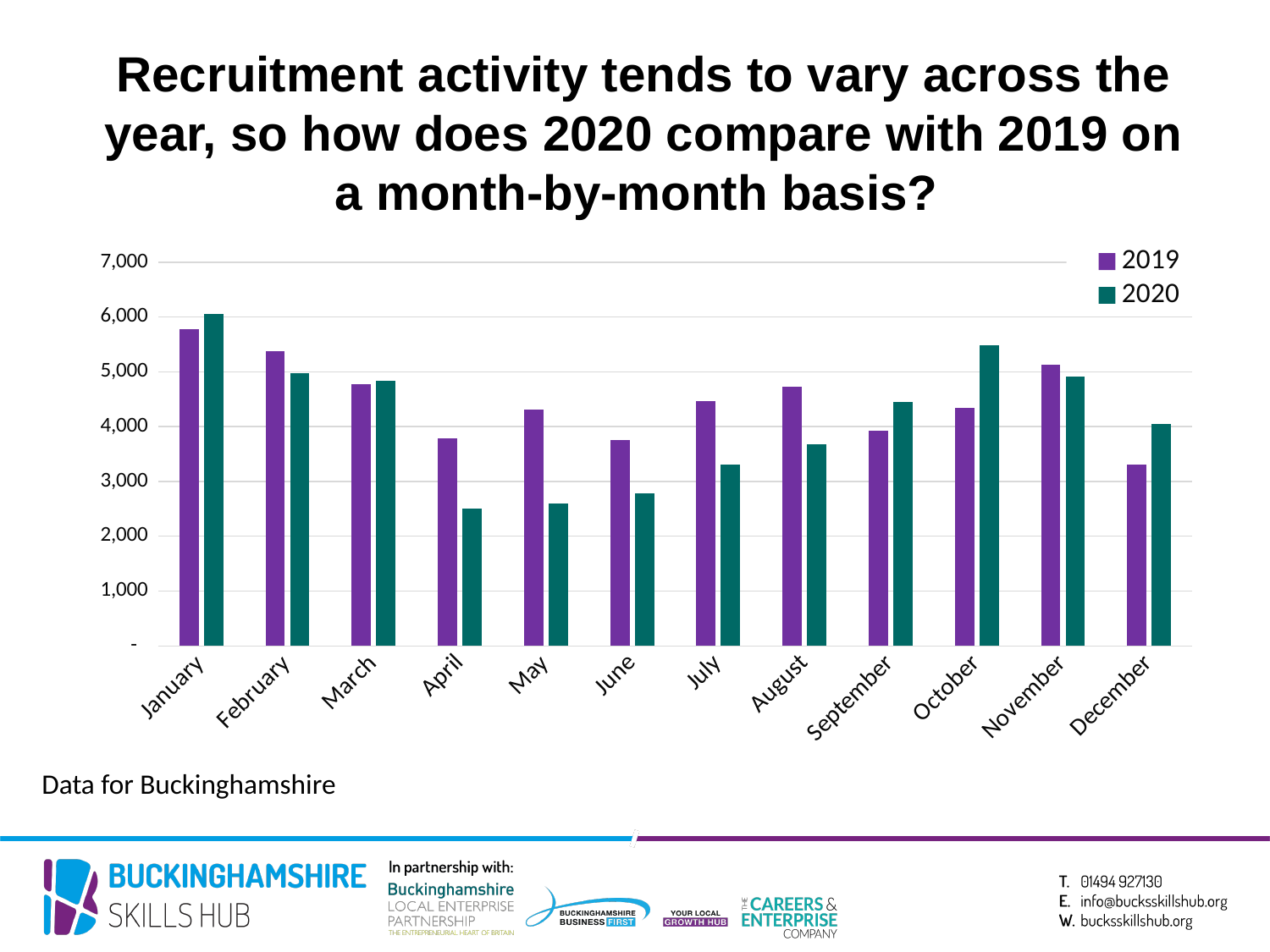
In April, which year has the larger value, 2019 or 2020? 2019 Which month has the highest value for 2020? January Is the value for April 2020 greater or less than 3,000? less Which month has the highest value for 2019? January Which month has the lowest value for 2019? December How many months are shown on the x axis? 12 Which colour represents the 2020 series in the legend? teal (dark green) How many series does the legend list? 2 Is the value for October 2020 greater or less than 5,000? greater In October, which year has the larger value, 2019 or 2020? 2020 What kind of chart is shown on the slide? bar chart Is the value for January 2019 greater or less than 5,000? greater